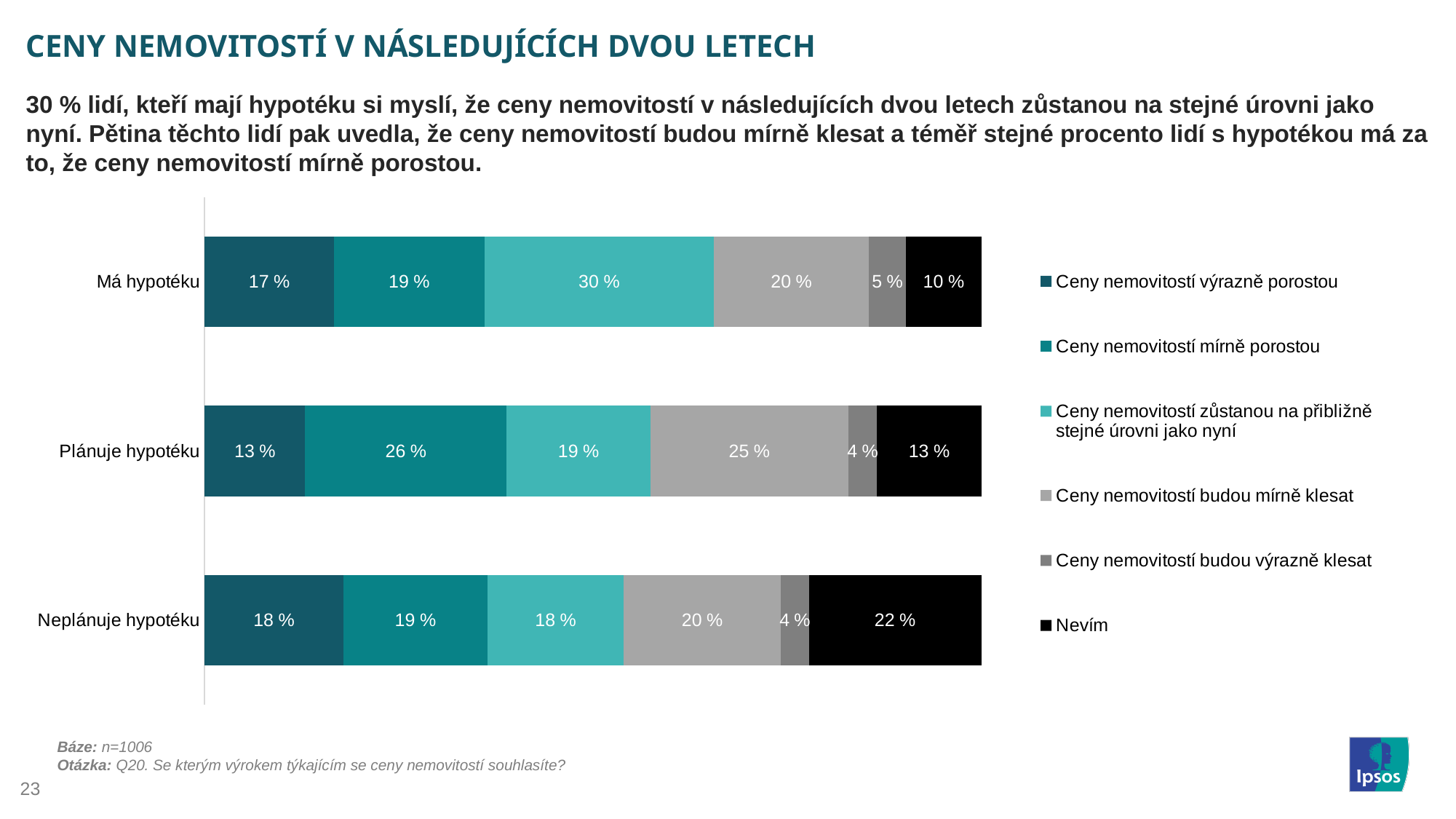
Which category has the highest value for "Nevím"? Neplánuje hypotéku What is the value for "Nevím" in the "Neplánuje hypotéku" bar? 22 % What is the value for "Ceny nemovitostí zůstanou na přibližně stejné úrovni jako nyní" in the "Má hypotéku" bar? 30 % How many categories are shown on the chart? 3 How many series does the legend list? 6 What kind of chart is shown on the slide? Stacked bar chart What is the value for "Ceny nemovitostí budou výrazně klesat" in the "Má hypotéku" bar? 5 % What is the difference between the "Ceny nemovitostí budou mírně klesat" values for "Plánuje hypotéku" and "Má hypotéku"? 5 % What is the value for "Ceny nemovitostí mírně porostou" in the "Plánuje hypotéku" bar? 26 % Which category has the lowest value for "Ceny nemovitostí výrazně porostou"? Plánuje hypotéku What is the total of the "Plánuje hypotéku" stacked bar? 100 % Which is larger: the "Ceny nemovitostí mírně porostou" value for "Plánuje hypotéku" or for "Neplánuje hypotéku"? Plánuje hypotéku